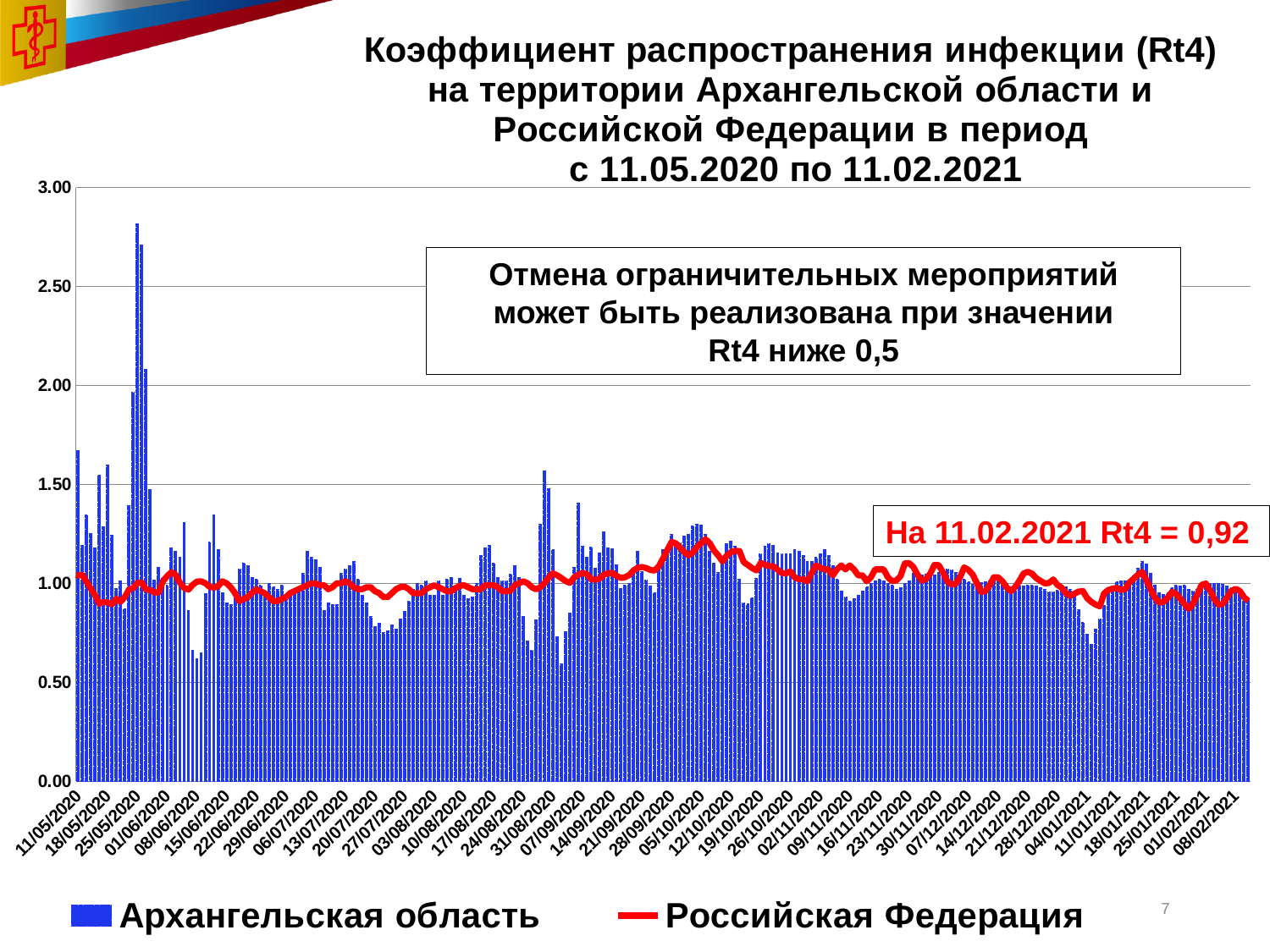
Which series is drawn as a red line? Российская Федерация In which month does the Архангельская область series reach its highest value? May 2020 According to the annotation on the chart, what is the Rt4 value on 11.02.2021? 0,92 Does the Российская Федерация line rise or fall from its peak around early October 2020 to the end of the period in February 2021? fall What are the two series named in the legend? Архангельская область and Российская Федерация What kind of chart is shown on the slide? A bar chart combined with a line chart Is the Российская Федерация line value at 08/02/2021 greater or less than 1.50? less Is the first bar for Архангельская область (11/05/2020) greater or less than 1.50? greater How many series does the legend list? 2 What is the maximum value shown on the vertical axis? 3.00 Is the Российская Федерация line value around 28/09/2020 greater or less than 1.00? greater